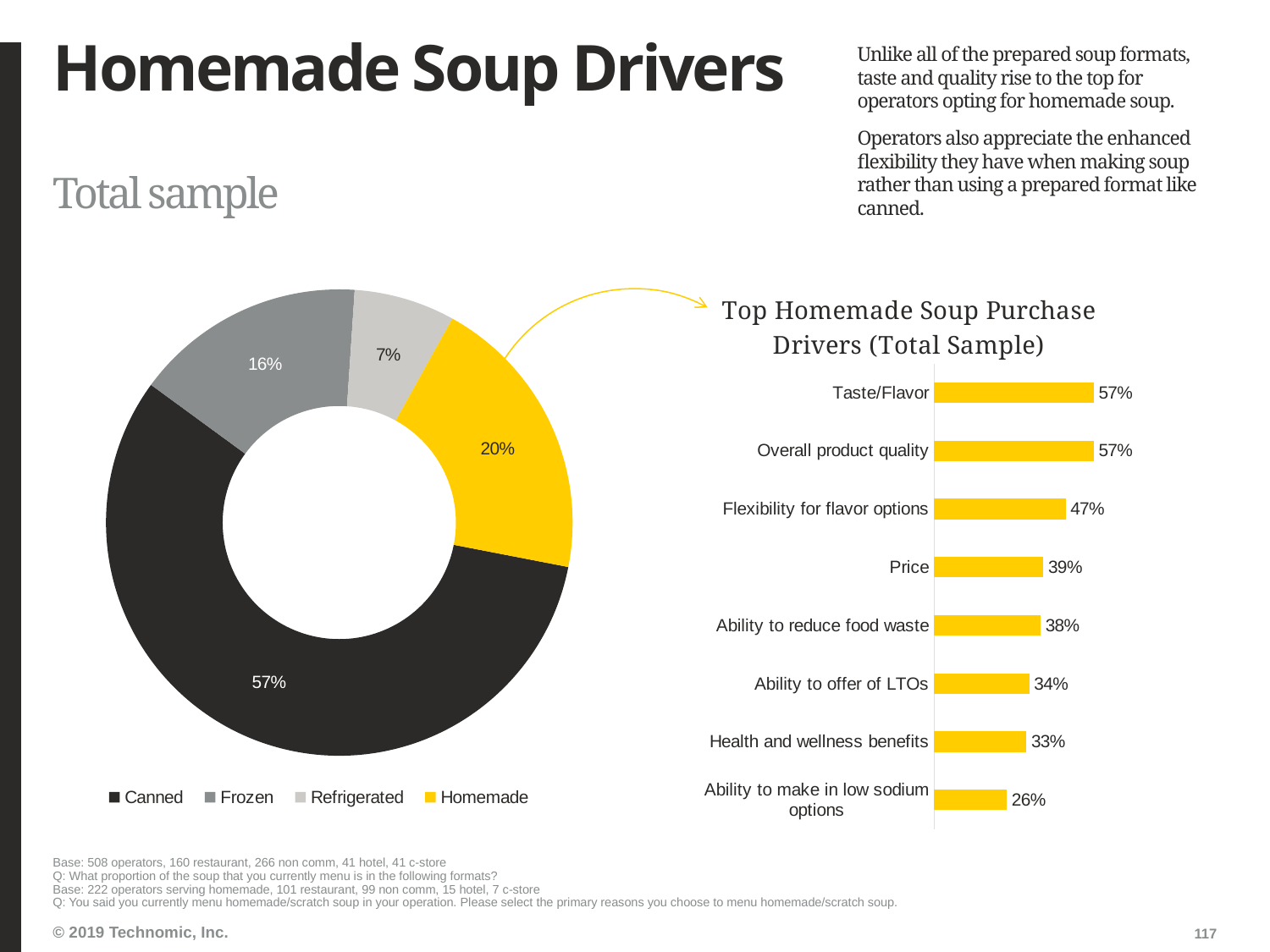
In the 'Top Homemade Soup Purchase Drivers (Total Sample)' chart, what is the difference between Taste/Flavor and Health and wellness benefits? 24% In the donut chart on the left, what is the difference between the Frozen and Refrigerated shares? 9% What type of chart is the 'Top Homemade Soup Purchase Drivers (Total Sample)' chart? Bar chart In the donut chart on the left, what share is Homemade? 20% In the 'Top Homemade Soup Purchase Drivers (Total Sample)' chart, which is larger: Ability to reduce food waste or Ability to offer of LTOs? Ability to reduce food waste In the donut chart on the left, how many formats does the legend list? 4 In the 'Top Homemade Soup Purchase Drivers (Total Sample)' chart, which driver has the lowest value? Ability to make in low sodium options In the 'Top Homemade Soup Purchase Drivers (Total Sample)' chart, what is the value for Price? 39% In the donut chart on the left, what share of soup menued is Canned? 57% In the 'Top Homemade Soup Purchase Drivers (Total Sample)' chart, how many drivers are shown? 8 In the donut chart on the left, which format has the smallest share? Refrigerated In the 'Top Homemade Soup Purchase Drivers (Total Sample)' chart, what is the value for Flexibility for flavor options? 47%